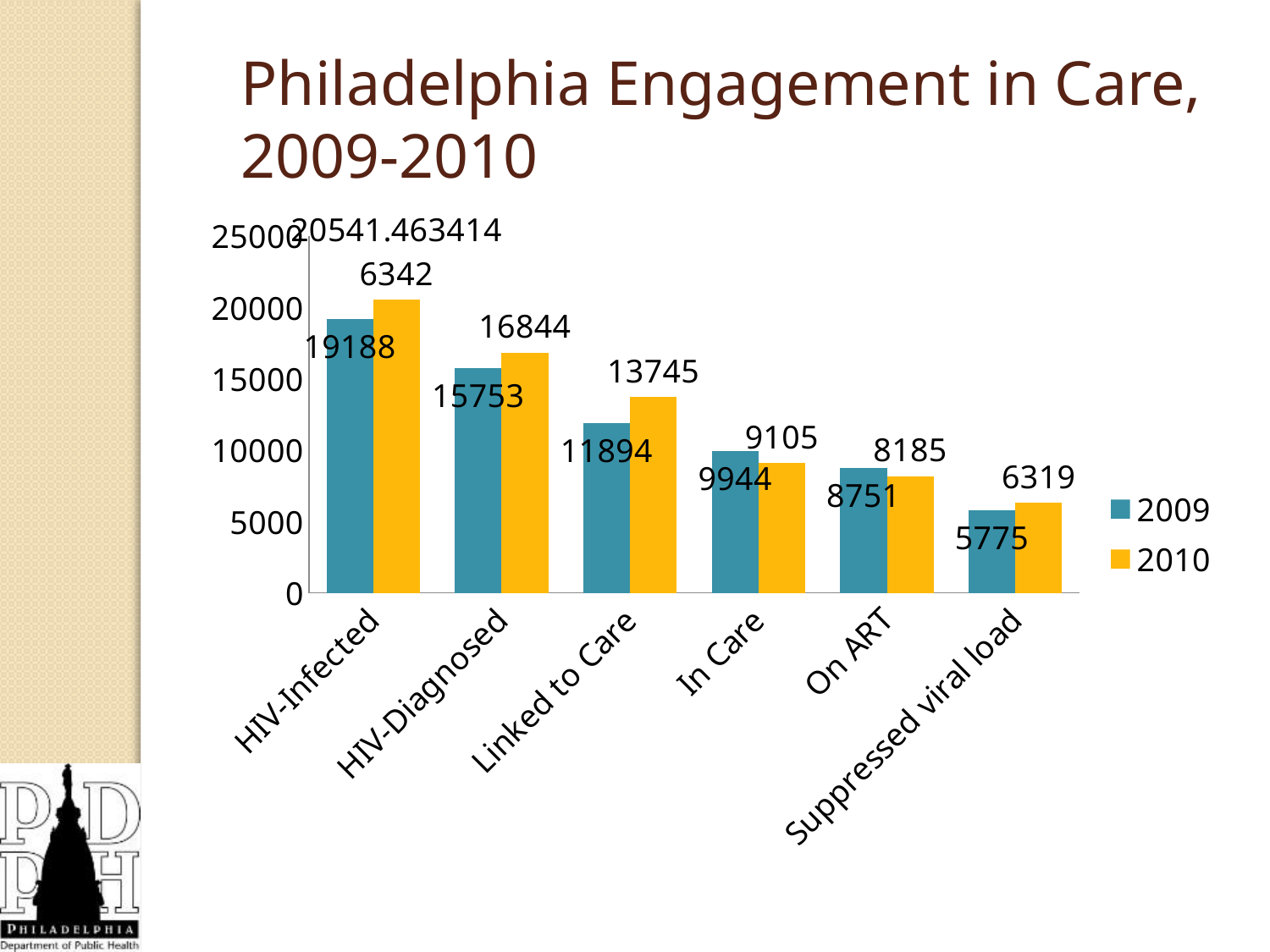
Which category has the highest 2009 value? HIV-Infected How many series does the legend list? 2 What is the 2010 value for On ART? 8185 What is the 2009 value for HIV-Diagnosed? 15753 Which category has the lowest 2010 value? Suppressed viral load How many categories are shown on the x axis? 6 For On ART, which year has the larger value, 2009 or 2010? 2009 What is the 2009 value for Suppressed viral load? 5775 What is the 2010 value for Linked to Care? 13745 What is the difference between the 2009 and 2010 values for In Care? 839 What is the difference between the 2010 and 2009 values for HIV-Diagnosed? 1091 Do the 2010 values rise or fall moving from left to right along the x axis? fall